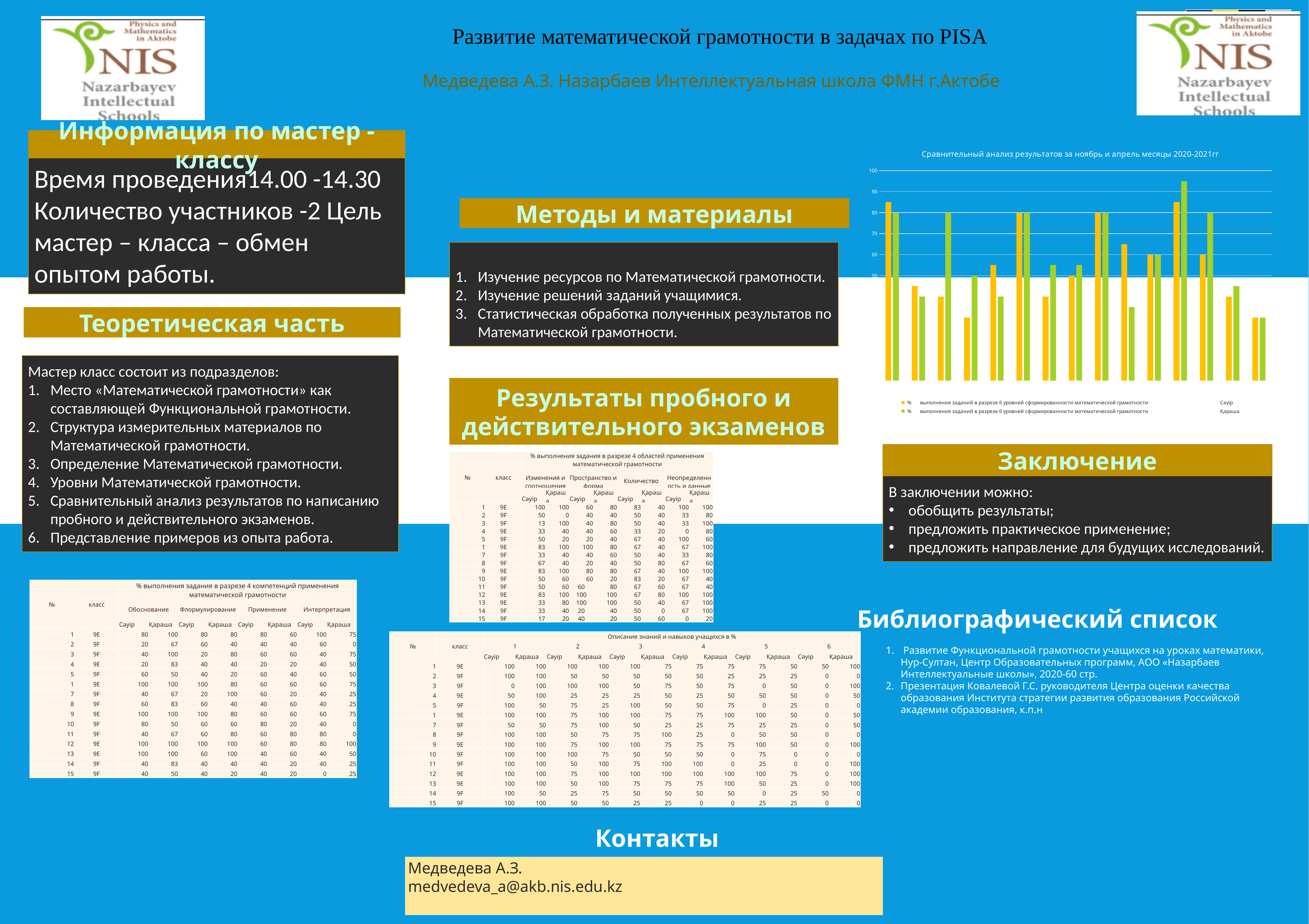
How many series does the chart's legend list? 2 What is the title of the chart on the slide? Сравнительный анализ результатов за ноябрь и апрель месяцы 2020-2021гг How many pairs of bars (categories) are plotted in the chart? 15 Is the shortest bar in the chart greater or less than 50? less Which month label in the legend corresponds to the green bars? Қараша Is the tallest bar in the chart greater or less than 90? greater What is the highest value shown on the chart's vertical axis? 100 Which series (Сәуір or Қараша) contains the tallest bar in the chart? Қараша What kind of chart is shown on the slide? bar chart Is the first (leftmost) yellow bar greater or less than 80? greater